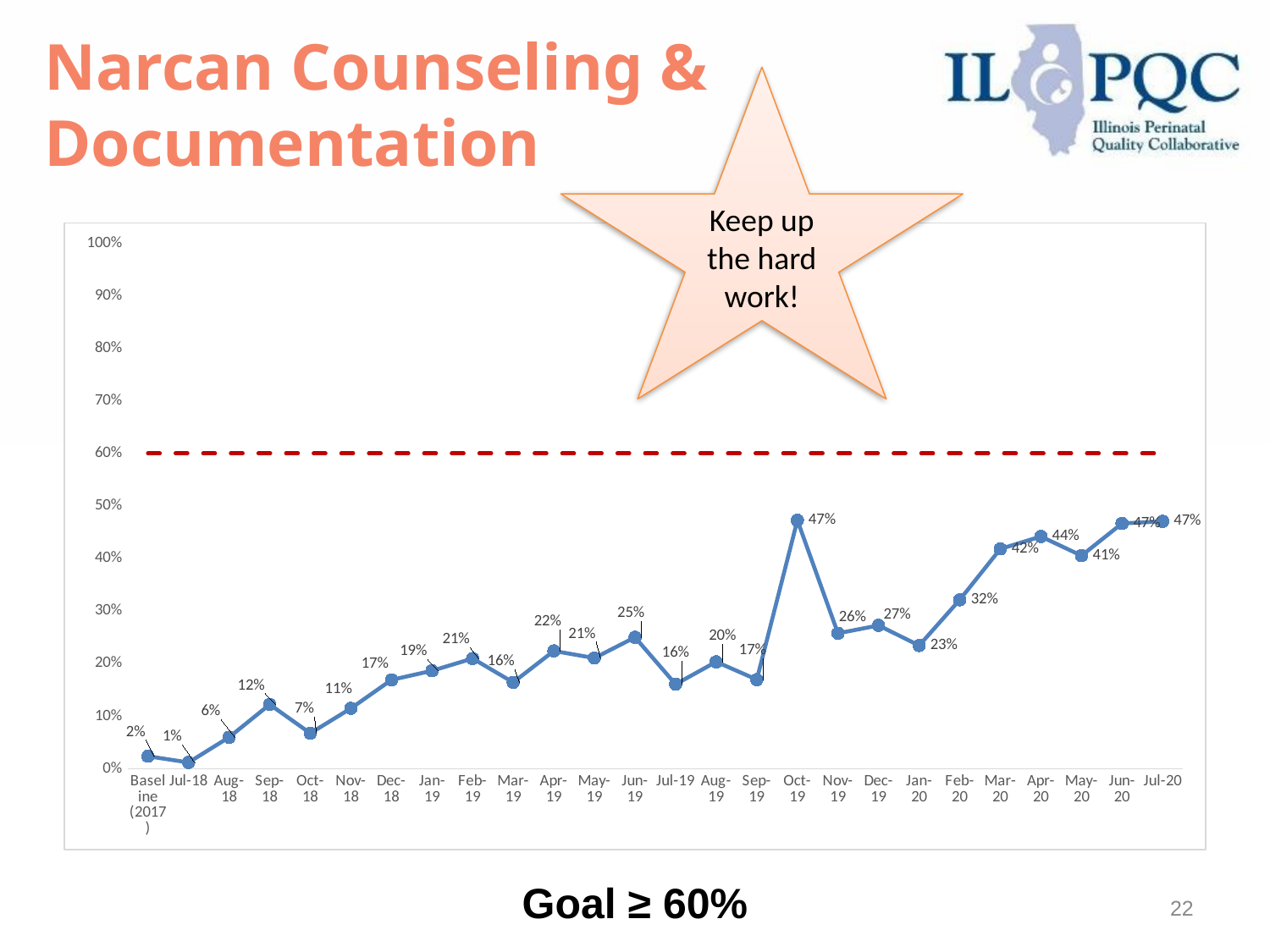
What kind of chart is shown on the slide? line chart What is the value for Oct-19? 47% Which month has the lowest value? Jul-18 What is the difference between the Mar-20 value and the Feb-20 value? 10 percentage points What is the difference between the Jul-20 value and the Baseline (2017) value? 45 percentage points What is the value for Feb-20? 32% What is the value for Sep-18? 12% Do the values generally rise or fall from Baseline (2017) to Jul-20? rise Which is larger, the value for Oct-19 or the value for Nov-19? Oct-19 How many data points are plotted on the chart? 26 At what percentage is the dashed red goal line drawn? 60% Is the value for Jul-20 greater or less than 60%? less